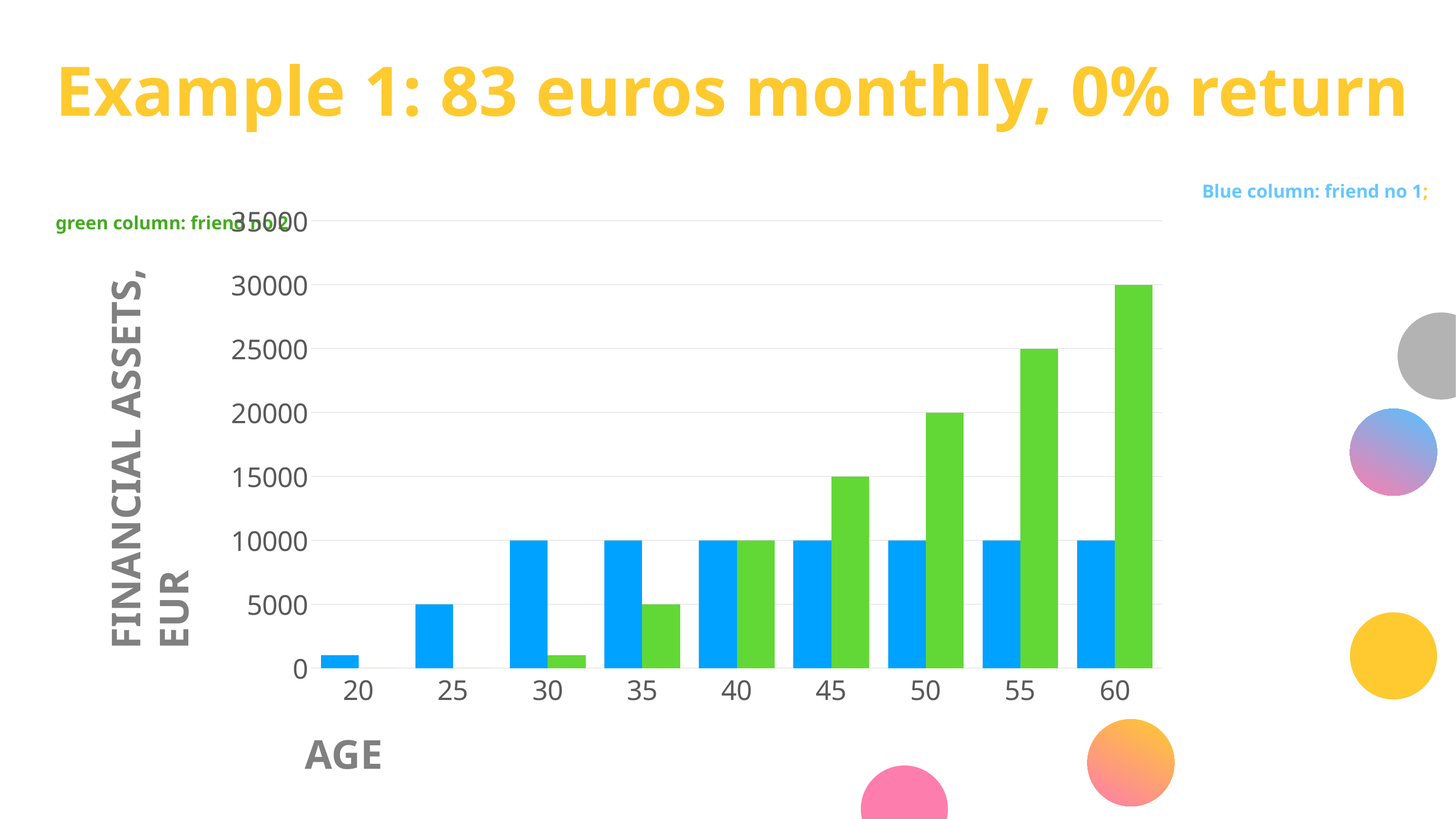
What is the value of the green bar (friend no 2) at age 45? 15000 At age 35, which bar is larger, the blue one or the green one? blue At which age is the blue bar (friend no 1) lowest? 20 What is the value of the green bar (friend no 2) at age 60? 30000 What is the value of the blue bar (friend no 1) at age 25? 5000 Is the value of the blue bar at age 20 greater or less than 5000? less How many age categories are shown on the x axis? 9 At which age is the green bar (friend no 2) highest? 60 What is the difference between the green bar and the blue bar at age 55? 15000 What kind of chart is shown on the slide? bar chart How many data series are plotted in the chart? 2 Do the green bars (friend no 2) rise or fall as age increases from 30 to 60? rise